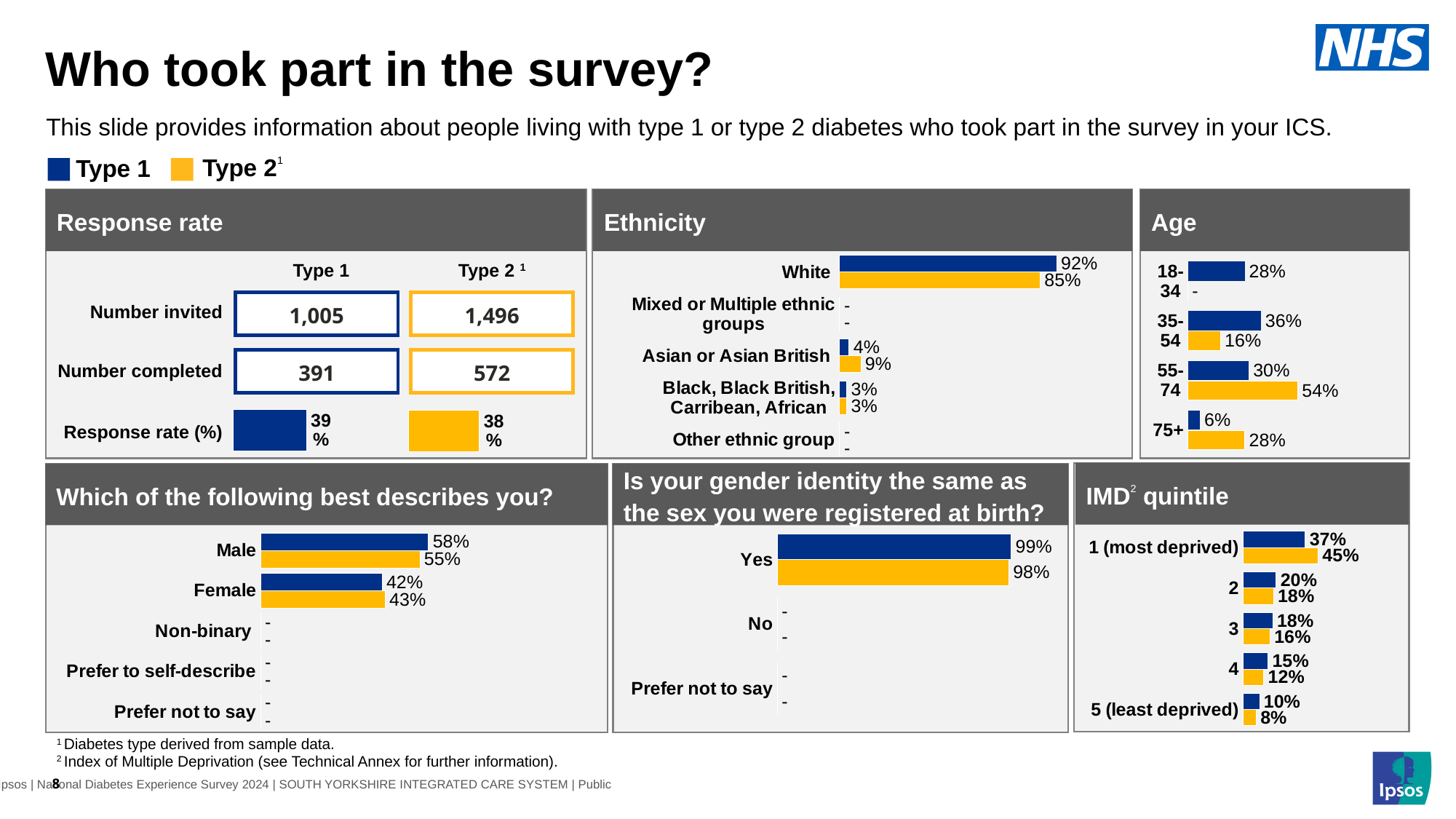
In the Ethnicity chart, what percentage of Type 2 respondents are Asian or Asian British? 9% In the Ethnicity chart, what percentage of Type 1 respondents are White? 92% In the Age chart, which age group has the highest Type 2 percentage? 55-74 In the IMD quintile chart, what is the difference between the Type 1 and Type 2 percentages for quintile 5 (least deprived)? 2 percentage points In the Response rate chart, what is the number completed for Type 2? 572 In the 'Which of the following best describes you?' chart, is the Type 1 percentage for Male larger or smaller than the Type 2 percentage for Male? larger In the Age chart, which age group has the lowest Type 1 percentage? 75+ In the Age chart, what is the difference between the Type 2 and Type 1 percentages for the 55-74 age group? 24 percentage points In the 'Which of the following best describes you?' chart, what percentage of Type 2 respondents are Female? 43% How many series does the legend at the top of the slide list? 2 In the IMD quintile chart, what is the Type 2 percentage for quintile 1 (most deprived)? 45% In the 'Is your gender identity the same as the sex you were registered at birth?' chart, what percentage of Type 1 respondents answered Yes? 99%